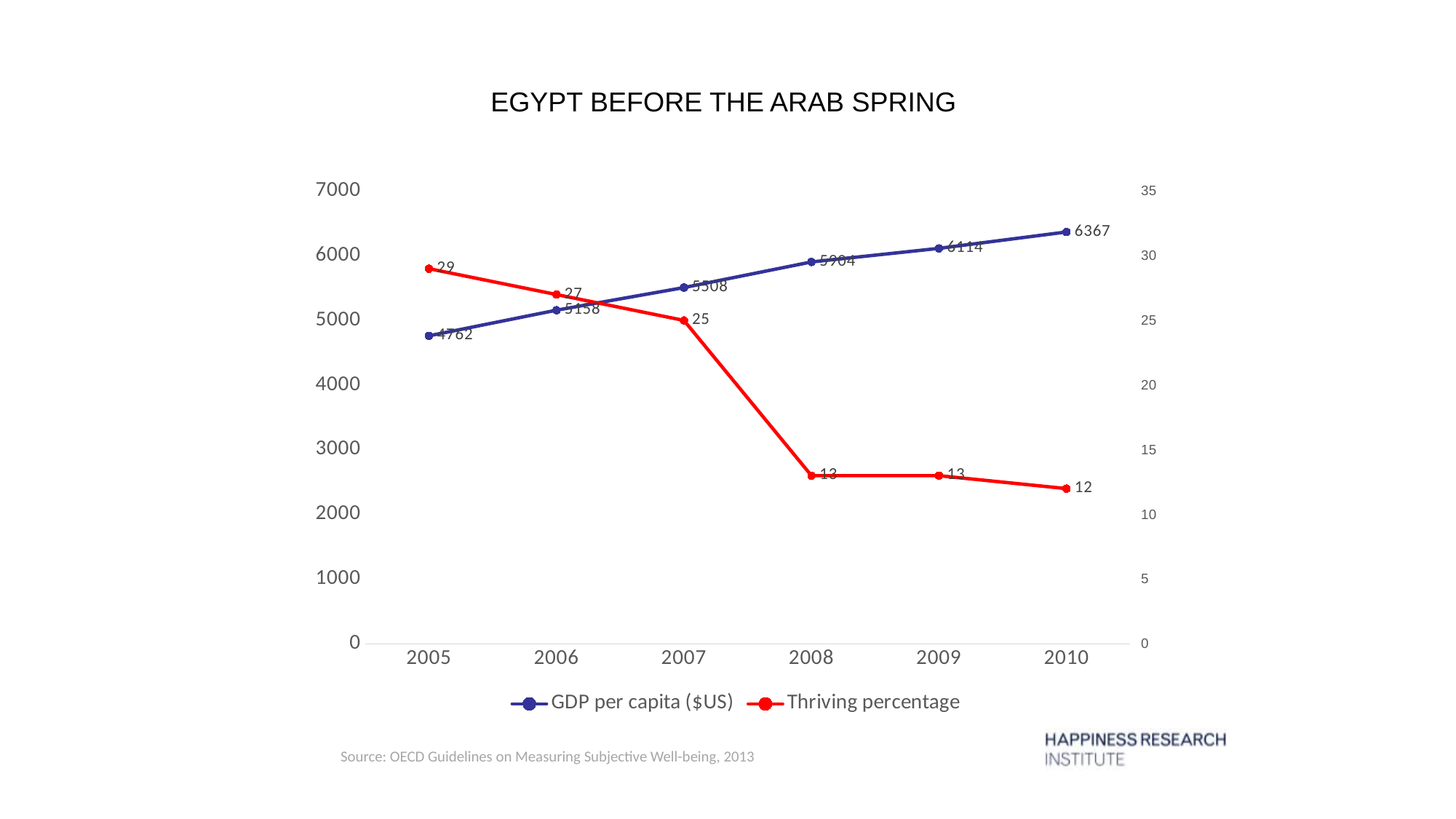
In which year is the Thriving percentage highest? 2005 What is the GDP per capita ($US) for Egypt in 2005? 4762 What type of chart is shown on the slide? Line chart What is the GDP per capita ($US) in 2010? 6367 How many series does the legend list? 2 Does the Thriving percentage rise or fall from 2005 to 2010? Fall How many years are plotted on the x axis? 6 In which year is the GDP per capita ($US) lowest? 2005 What is the Thriving percentage in 2008? 13 Which is larger, the GDP per capita ($US) in 2007 or in 2009? 2009 What is the difference in Thriving percentage between 2007 and 2008? 12 By how much did GDP per capita ($US) increase from 2005 to 2010? 1605